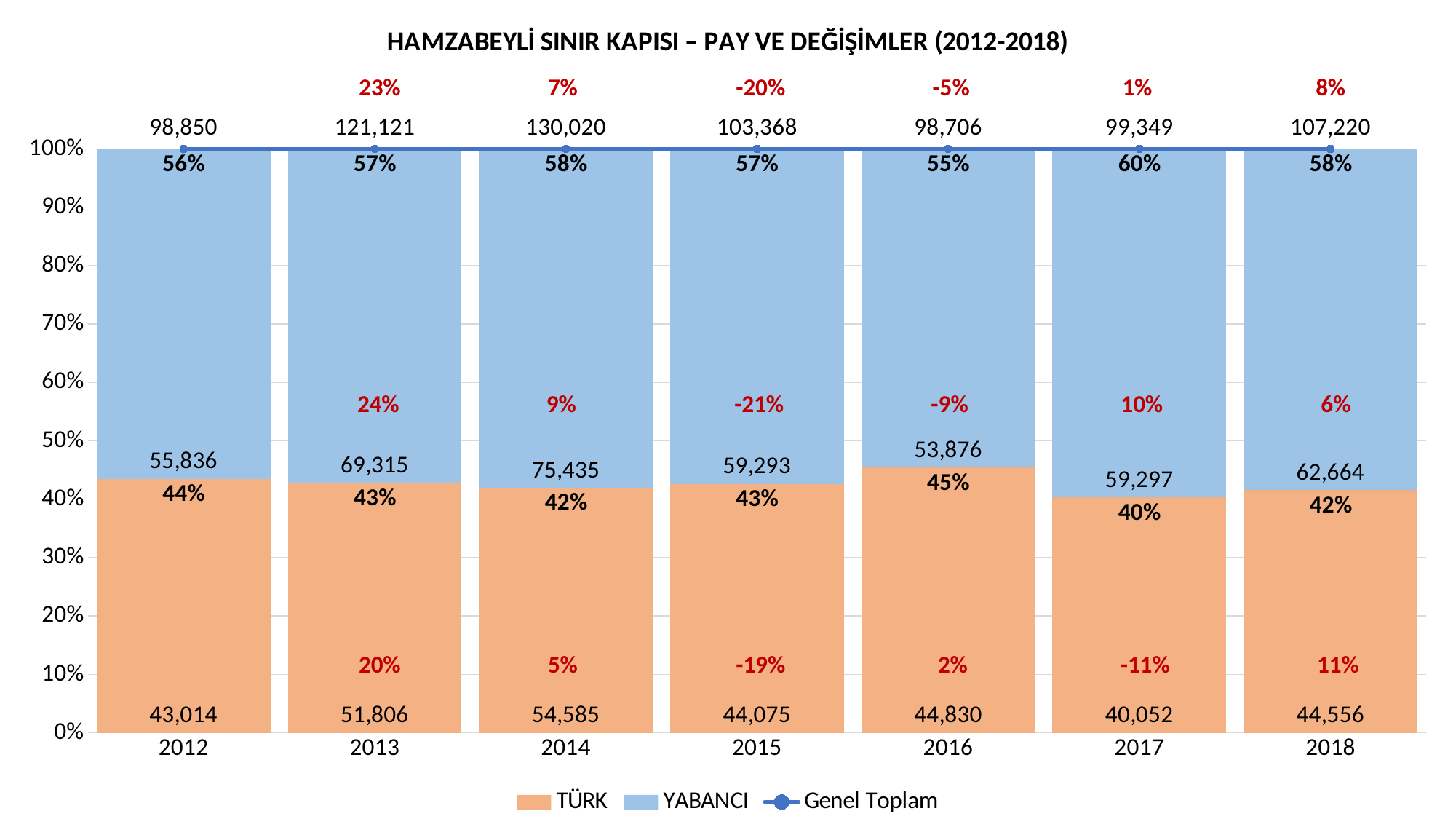
What is the difference between the YABANCI values for 2014 and 2012? 19,599 What kind of chart is this? Stacked bar chart with a line How many years are shown on the x axis? 7 Which year has the larger TÜRK value, 2013 or 2016? 2013 What is the Genel Toplam value for 2013? 121,121 How many series does the legend list? 3 What percentage share does TÜRK have in 2017? 40% What is the percentage change shown above the Genel Toplam value for 2015? -20% What is the TÜRK value for 2014? 54,585 What is the YABANCI value for 2018? 62,664 Which year has the highest Genel Toplam value? 2014 Which year has the lowest TÜRK value? 2017